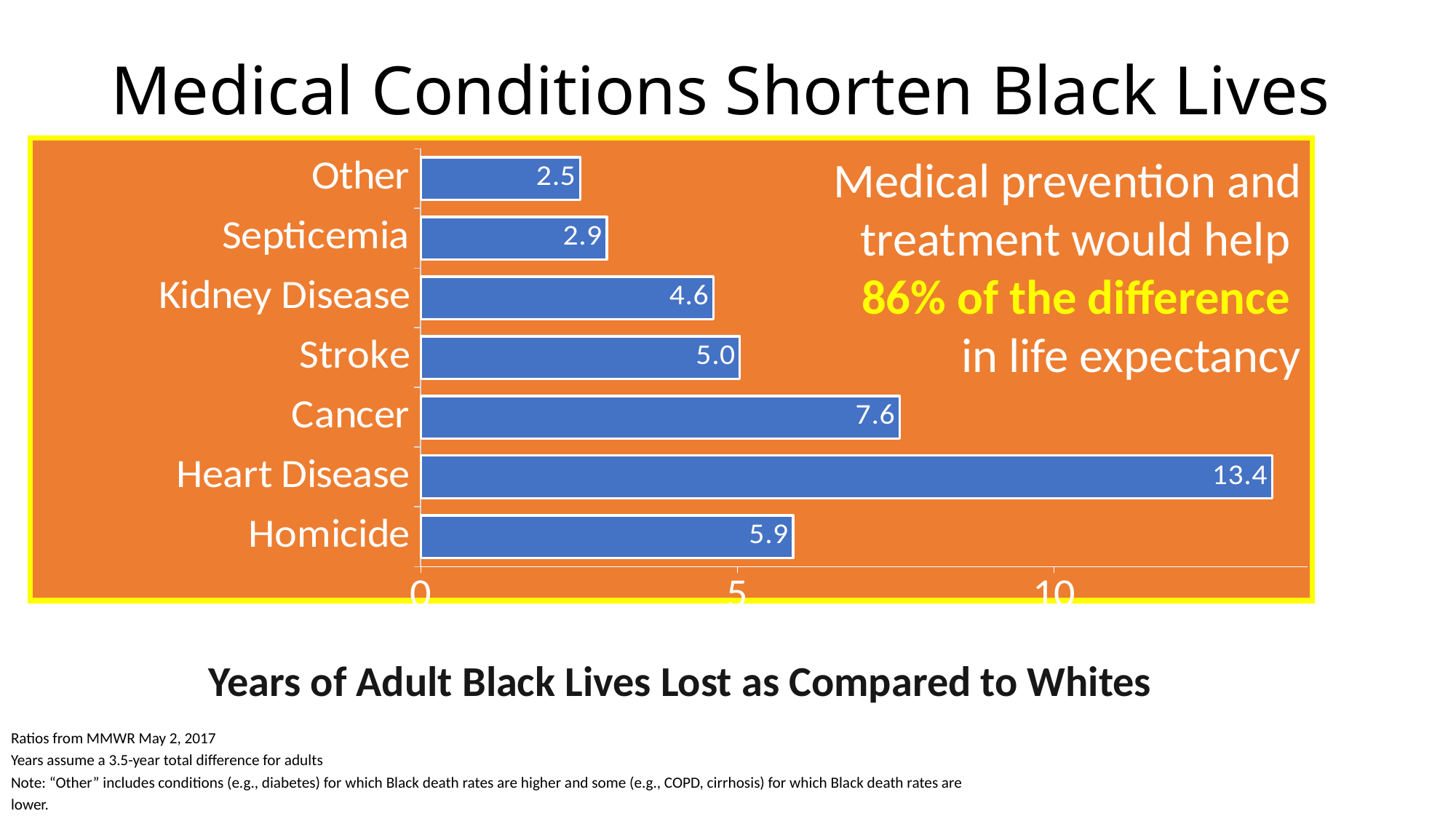
Which is larger, the value for Homicide or the value for Kidney Disease? Homicide What is the difference between the values for Stroke and Other? 2.5 Which category has the lowest value? Other Is the value for Cancer greater or less than 5? greater What is the difference between the values for Heart Disease and Cancer? 5.8 What is the value for Septicemia? 2.9 What is the value for Heart Disease? 13.4 What kind of chart is shown on the slide? bar chart What is the caption below the chart? Years of Adult Black Lives Lost as Compared to Whites How many categories are shown in the chart? 7 What is the value for Stroke? 5.0 Which category has the highest value? Heart Disease